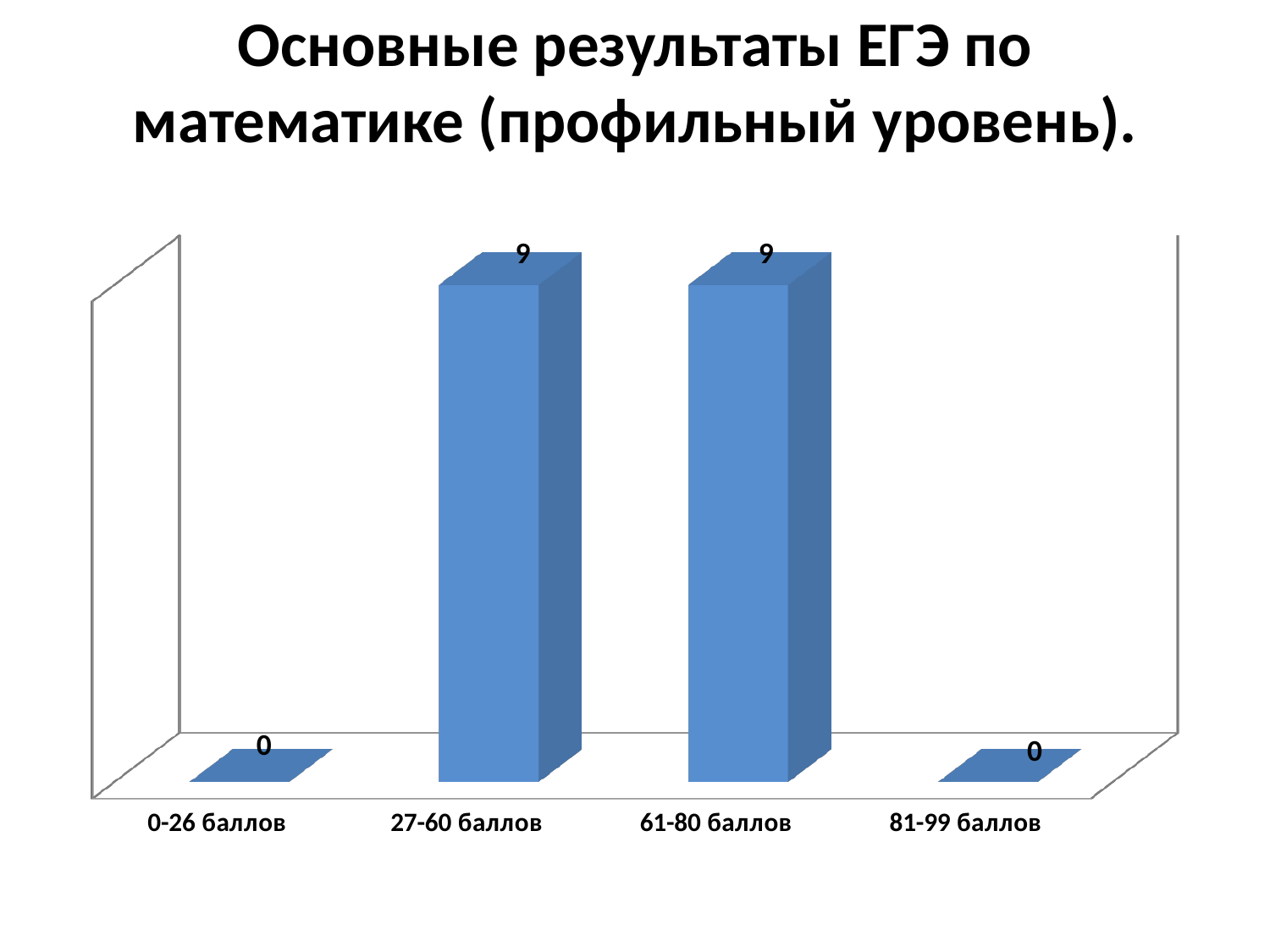
What is the difference between the values for 27-60 баллов and 61-80 баллов? 0 Which is larger, the value for 61-80 баллов or the value for 81-99 баллов? 61-80 баллов What is the value for the 61-80 баллов category? 9 What colour are the bars in the chart? blue What is the difference between the values for 27-60 баллов and 0-26 баллов? 9 What is the title of the slide? Основные результаты ЕГЭ по математике (профильный уровень). What is the value for the 0-26 баллов category? 0 What is the total of the values for all four categories? 18 How many categories are shown on the x axis? 4 What is the value for the 27-60 баллов category? 9 What kind of chart is shown on the slide? bar chart What is the value for the 81-99 баллов category? 0